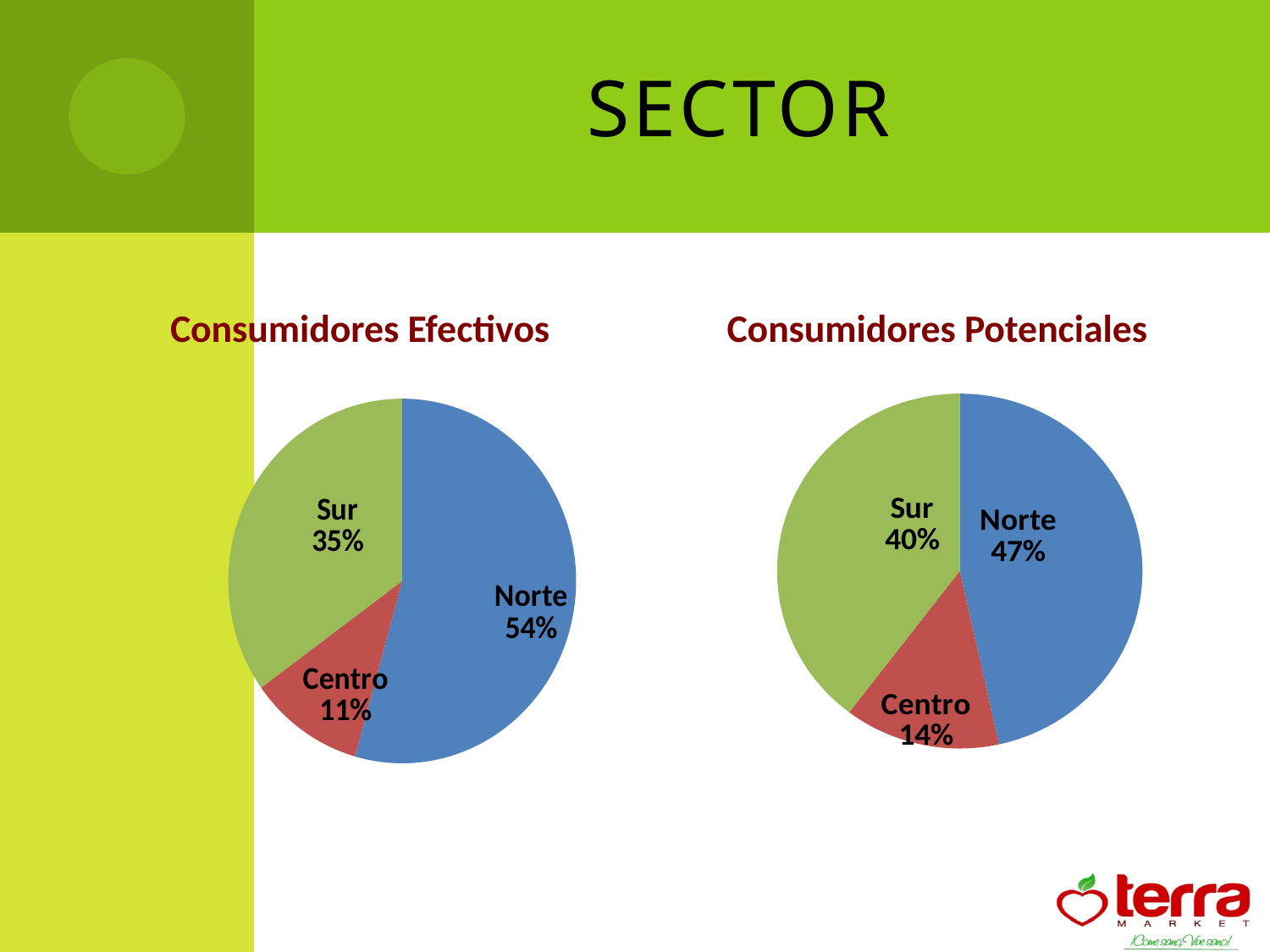
What is the title of the chart on the left side of the slide? Consumidores Efectivos In the 'Consumidores Potenciales' chart, what share does Sur have? 40% In the 'Consumidores Potenciales' chart, which is larger, Sur or Centro? Sur In the 'Consumidores Efectivos' chart, which sector has the smallest share? Centro In the 'Consumidores Potenciales' chart, which sector has the largest share? Norte In the 'Consumidores Efectivos' chart, what share does Norte have? 54% In the 'Consumidores Potenciales' chart, what colour is the Centro slice? Red What type of chart is 'Consumidores Potenciales'? Pie chart In the 'Consumidores Efectivos' chart, what is the value for Centro? 11% How many slices does the 'Consumidores Efectivos' pie chart have? 3 In the 'Consumidores Potenciales' chart, what is the difference between the Norte and Centro shares? 33% In the 'Consumidores Efectivos' chart, what is the difference between the Norte and Sur shares? 19%